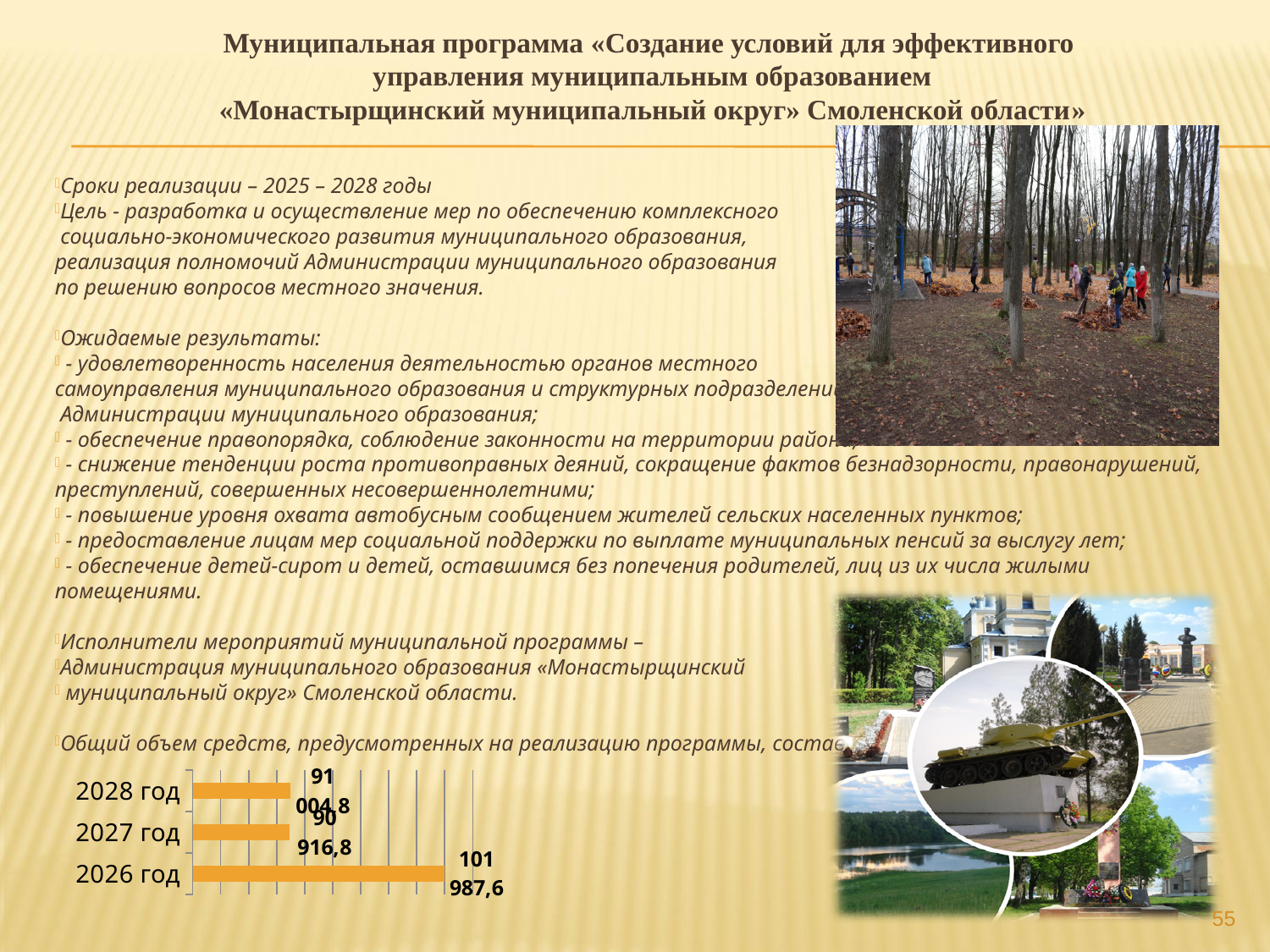
What is the value shown for 2026 год in the bar chart? 101 987,6 What kind of chart is shown at the bottom of the slide? Bar chart Which year has the highest value in the bar chart? 2026 год What is the difference between the values for 2028 год and 2027 год? 88 What is the value shown for 2028 год in the bar chart? 91 004,8 What colour are the bars in the chart? Orange What is the difference between the values for 2026 год and 2027 год? 11 070,8 What is the difference between the values for 2026 год and 2028 год? 10 982,8 What is the value shown for 2027 год in the bar chart? 90 916,8 Which year has the lowest value in the bar chart? 2027 год How many years (categories) are shown in the bar chart? 3 Which is larger, the value for 2026 год or the value for 2027 год? 2026 год